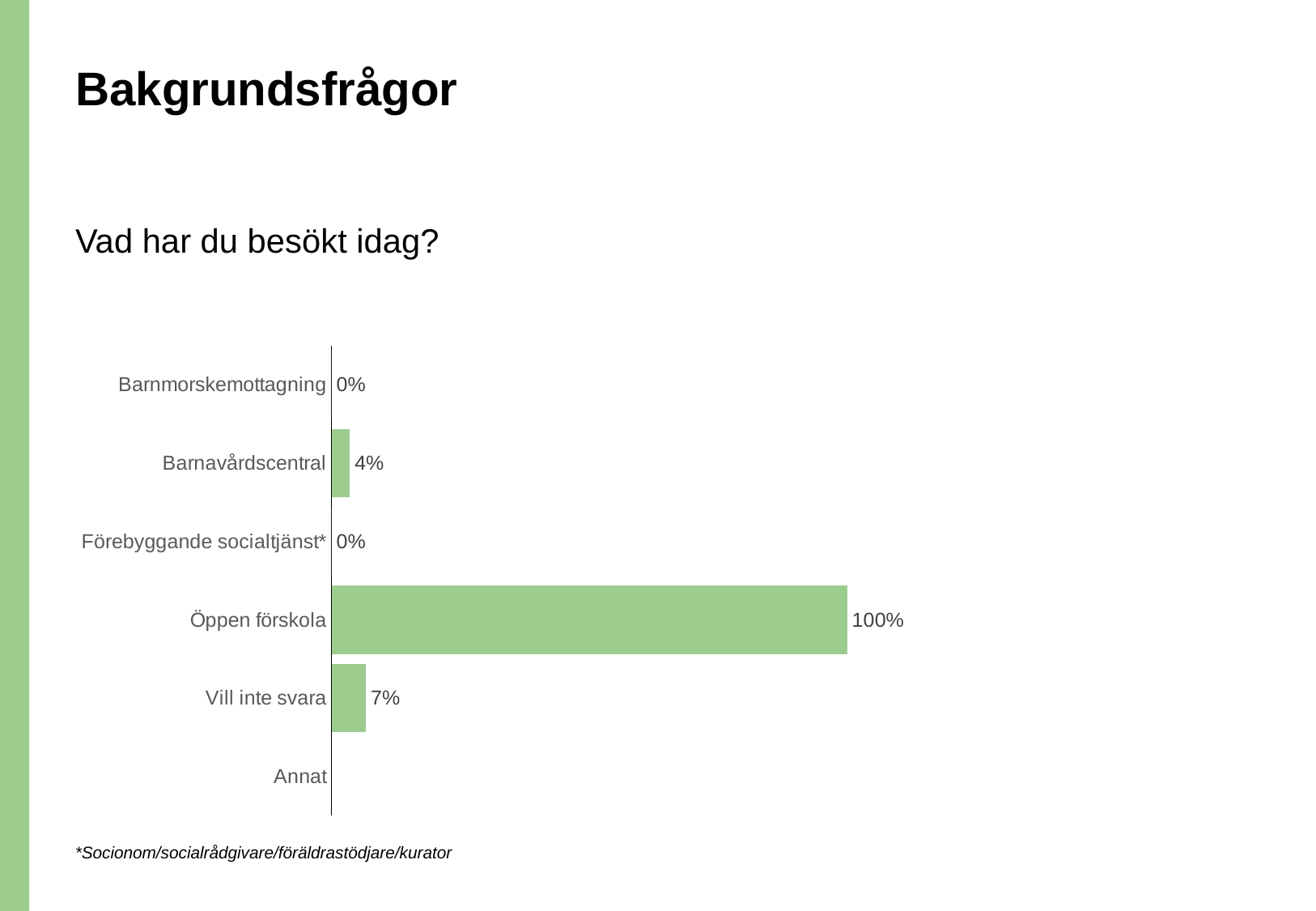
What is the difference between the values for Öppen förskola and Vill inte svara? 93% How many categories are shown on the chart? 6 What is the value for Vill inte svara? 7% Which category has the highest value? Öppen förskola What question does the chart answer, as stated above it? Vad har du besökt idag? What is the value for Barnmorskemottagning? 0% Which is larger, the value for Vill inte svara or the value for Barnavårdscentral? Vill inte svara What is the difference between the values for Vill inte svara and Barnavårdscentral? 3% What is the value for Barnavårdscentral? 4% What is the value for Öppen förskola? 100% What kind of chart is shown on the slide? Bar chart What is the value for Förebyggande socialtjänst*? 0%